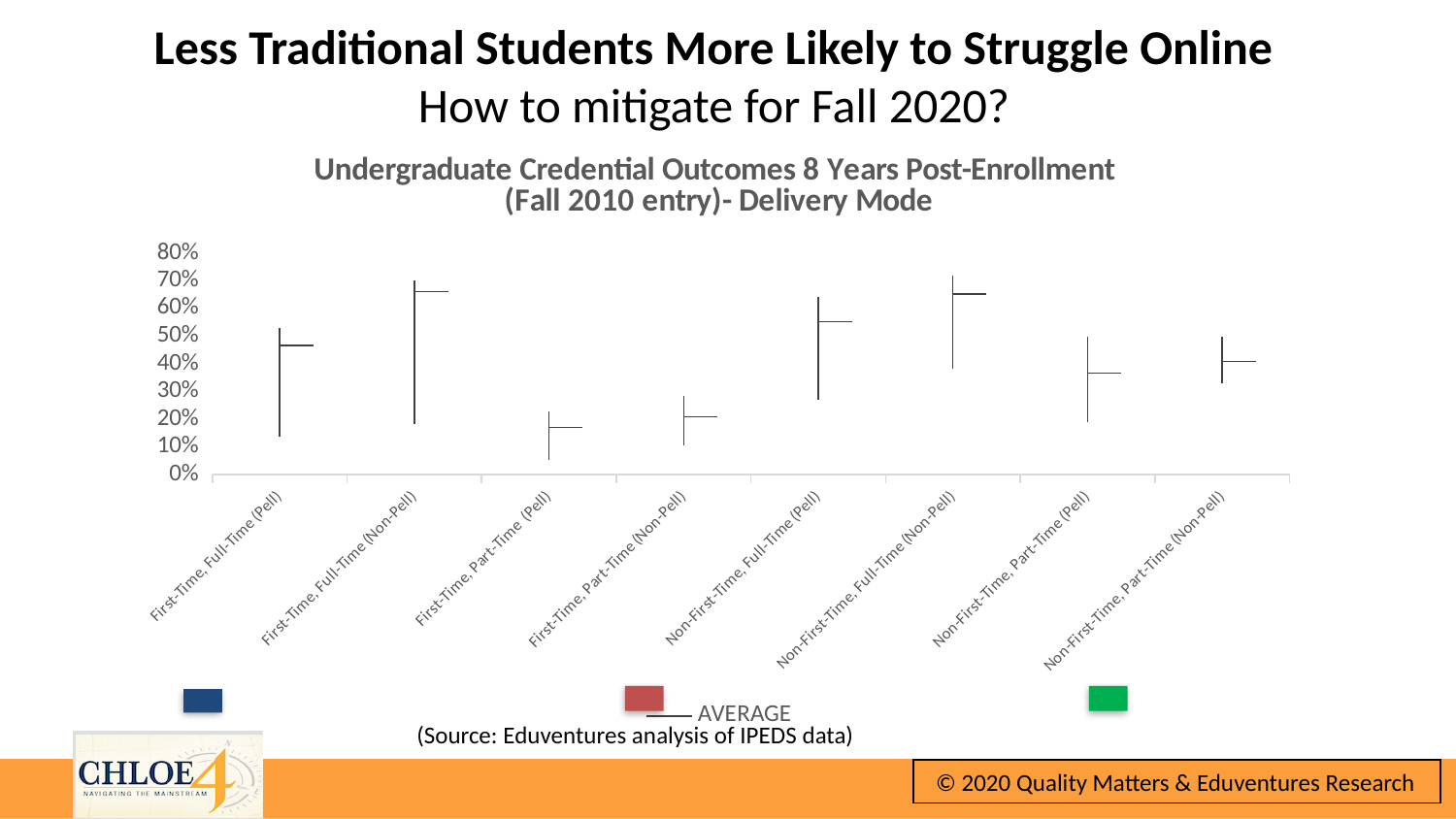
Which has a higher average value: First-Time, Full-Time (Non-Pell) or First-Time, Part-Time (Non-Pell)? First-Time, Full-Time (Non-Pell) Is the average value for First-Time, Full-Time (Pell) greater or less than 30%? greater Is the average value for First-Time, Full-Time (Non-Pell) greater or less than 60%? greater Which has a higher average value: First-Time, Part-Time (Pell) or Non-First-Time, Full-Time (Pell)? Non-First-Time, Full-Time (Pell) Is the average value for First-Time, Part-Time (Pell) greater or less than 20%? less What is the maximum value shown on the chart's vertical axis? 80% How many student categories are shown along the x axis of the chart? 8 What is the title of the chart? Undergraduate Credential Outcomes 8 Years Post-Enrollment (Fall 2010 entry)- Delivery Mode